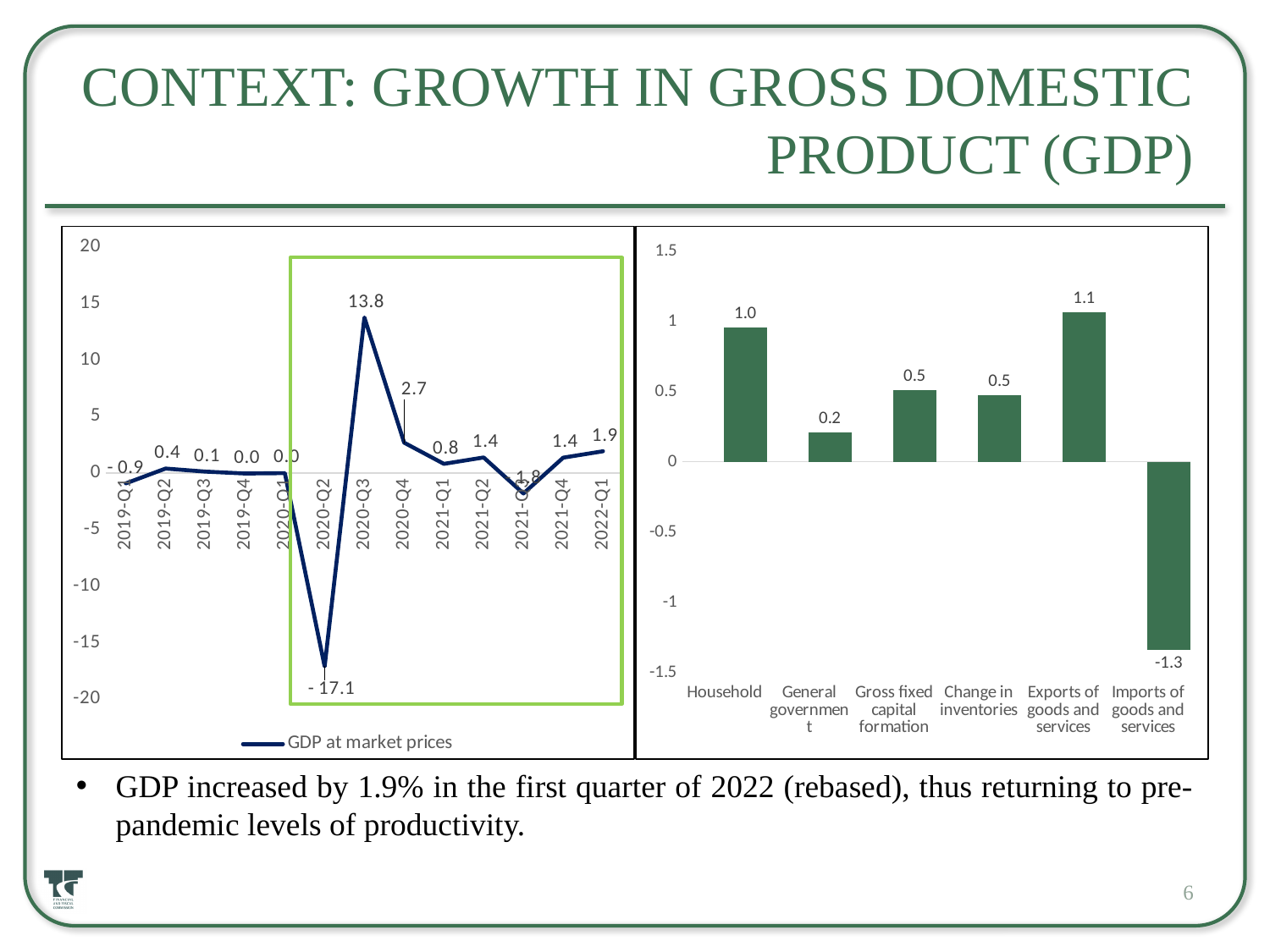
In the right chart, which is larger, the value for Household or the value for General government? Household In the left chart, what is the value of GDP at market prices for 2020-Q3? 13.8 In the left chart, what is the value of GDP at market prices for 2022-Q1? 1.9 In the left chart, which quarter has the lowest value of GDP at market prices? 2020-Q2 In the right chart, what is the value for Exports of goods and services? 1.1 What type of chart is the left chart? Line chart In the left chart, what is the value of GDP at market prices for 2020-Q2? -17.1 In the left chart, what is the difference between the values for 2020-Q3 and 2020-Q4? 11.1 In the right chart, which category has the highest value? Exports of goods and services In the left chart, which quarter has the highest value of GDP at market prices? 2020-Q3 In the right chart, what is the value for Imports of goods and services? -1.3 In the left chart, how many quarters are plotted on the x axis? 13